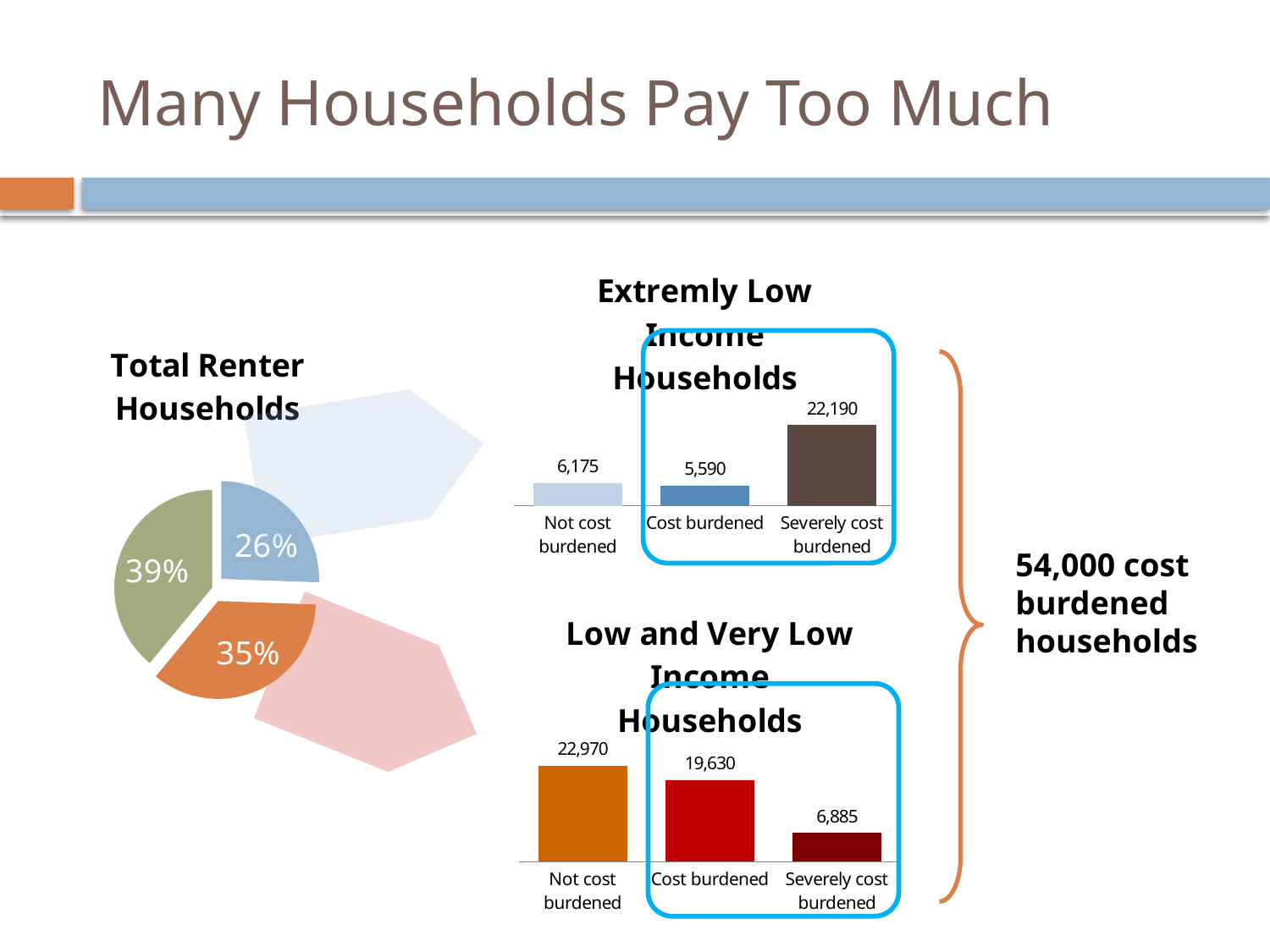
In the Extremly Low Income Households chart, what is the difference between Not cost burdened and Cost burdened? 585 In the Low and Very Low Income Households chart, which category has the lowest value? Severely cost burdened What kind of chart is the Total Renter Households chart? Pie chart Which is larger: Cost burdened in the Extremly Low Income Households chart or Cost burdened in the Low and Very Low Income Households chart? Low and Very Low Income Households How many categories does the Low and Very Low Income Households chart show? 3 In the Low and Very Low Income Households chart, what is the difference between Not cost burdened and Cost burdened? 3,340 In the Total Renter Households pie chart, what is the largest percentage shown on a slice? 39% In the Extremly Low Income Households chart, what is the value for Severely cost burdened? 22,190 In the Low and Very Low Income Households chart, what is the value for Severely cost burdened? 6,885 In the Low and Very Low Income Households chart, what is the value for Not cost burdened? 22,970 In the Extremly Low Income Households chart, what is the value for Cost burdened? 5,590 In the Extremly Low Income Households chart, which category has the highest value? Severely cost burdened